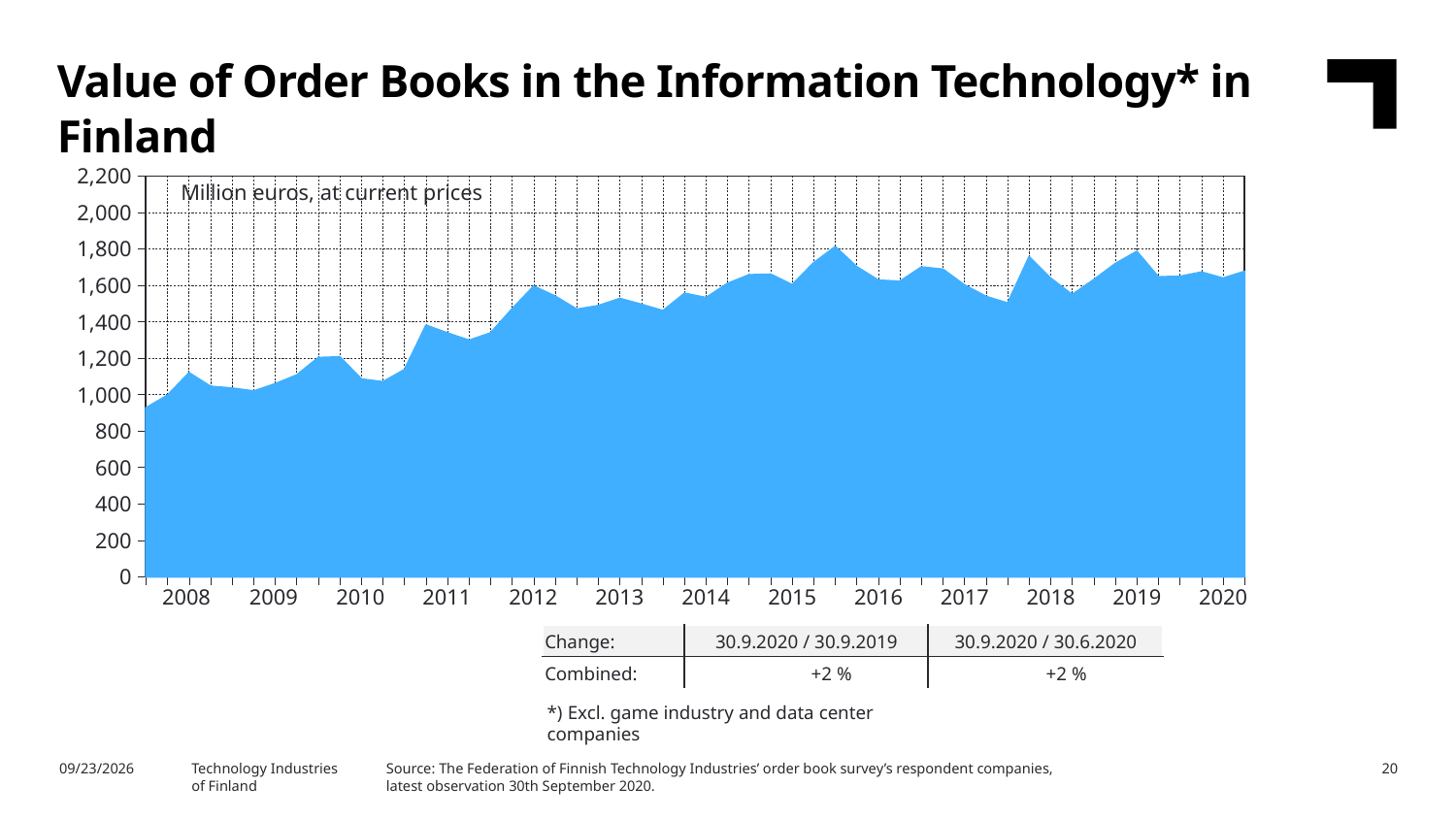
Does the value ever exceed 2,000 at any point on the chart? No According to the table below the chart, what is the combined change for 30.9.2020 / 30.9.2019? +2 % Is the value at the start of 2008 greater or less than 1,200? less What kind of chart is shown on the slide? Area chart Is the value in 2020 greater or less than 1,400? greater How many year labels are shown on the x axis? 13 Overall, do the values rise or fall from 2008 to 2020? Rise What unit is the value of order books measured in, according to the label inside the chart? Million euros, at current prices What is the title of the chart on the slide? Value of Order Books in the Information Technology* in Finland